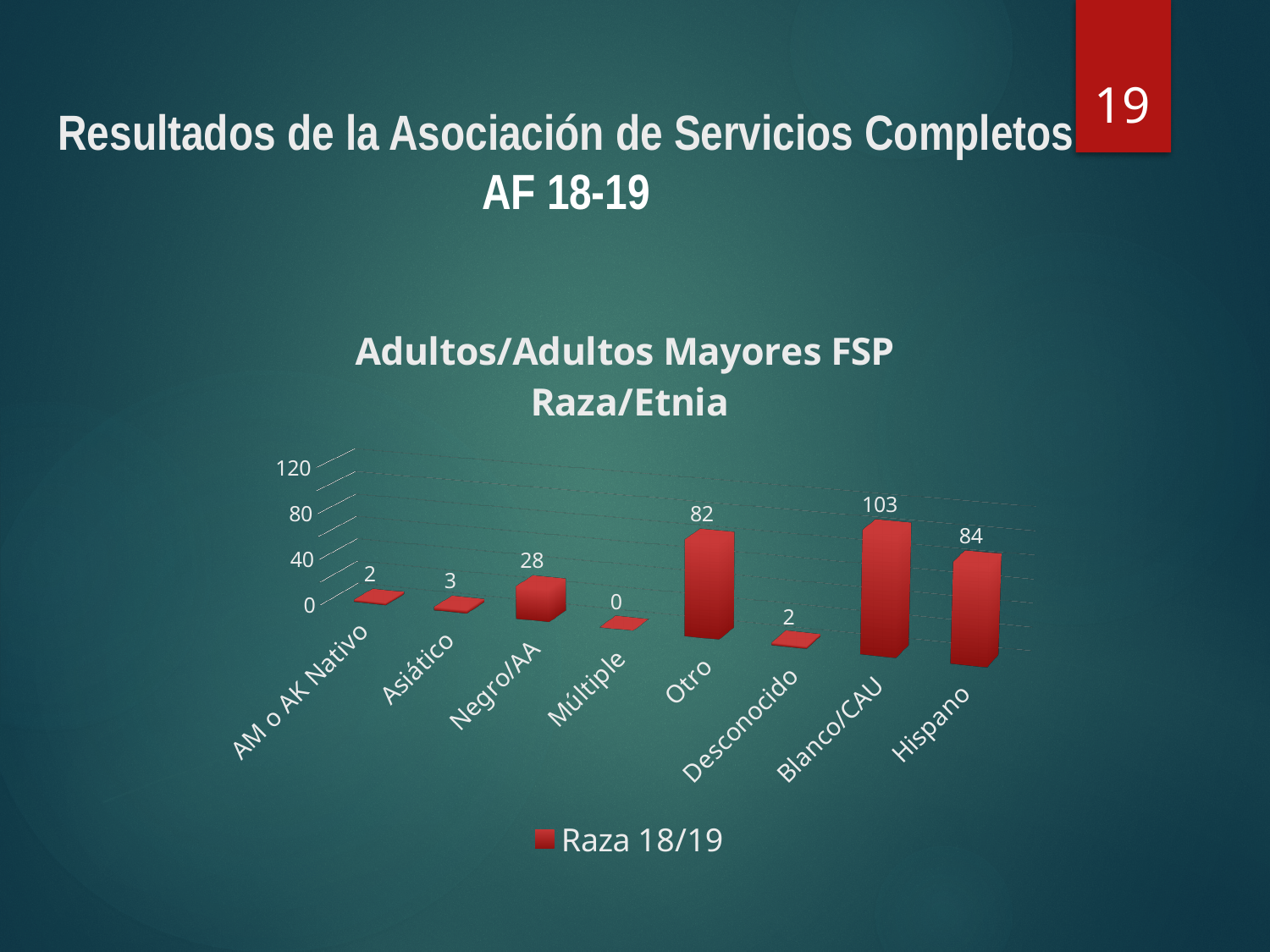
What is the value for Otro? 82 What is the difference between the values for Blanco/CAU and Hispano? 19 Which is larger, the value for Otro or the value for Hispano? Hispano What is the value for Blanco/CAU? 103 What is the legend entry for the series? Raza 18/19 What kind of chart is shown? bar chart How many categories are shown on the x axis? 8 What is the value for Negro/AA? 28 How many series does the legend list? 1 Is the value for Otro greater or less than 40? greater Which category has the lowest value? Múltiple Which category has the highest value? Blanco/CAU